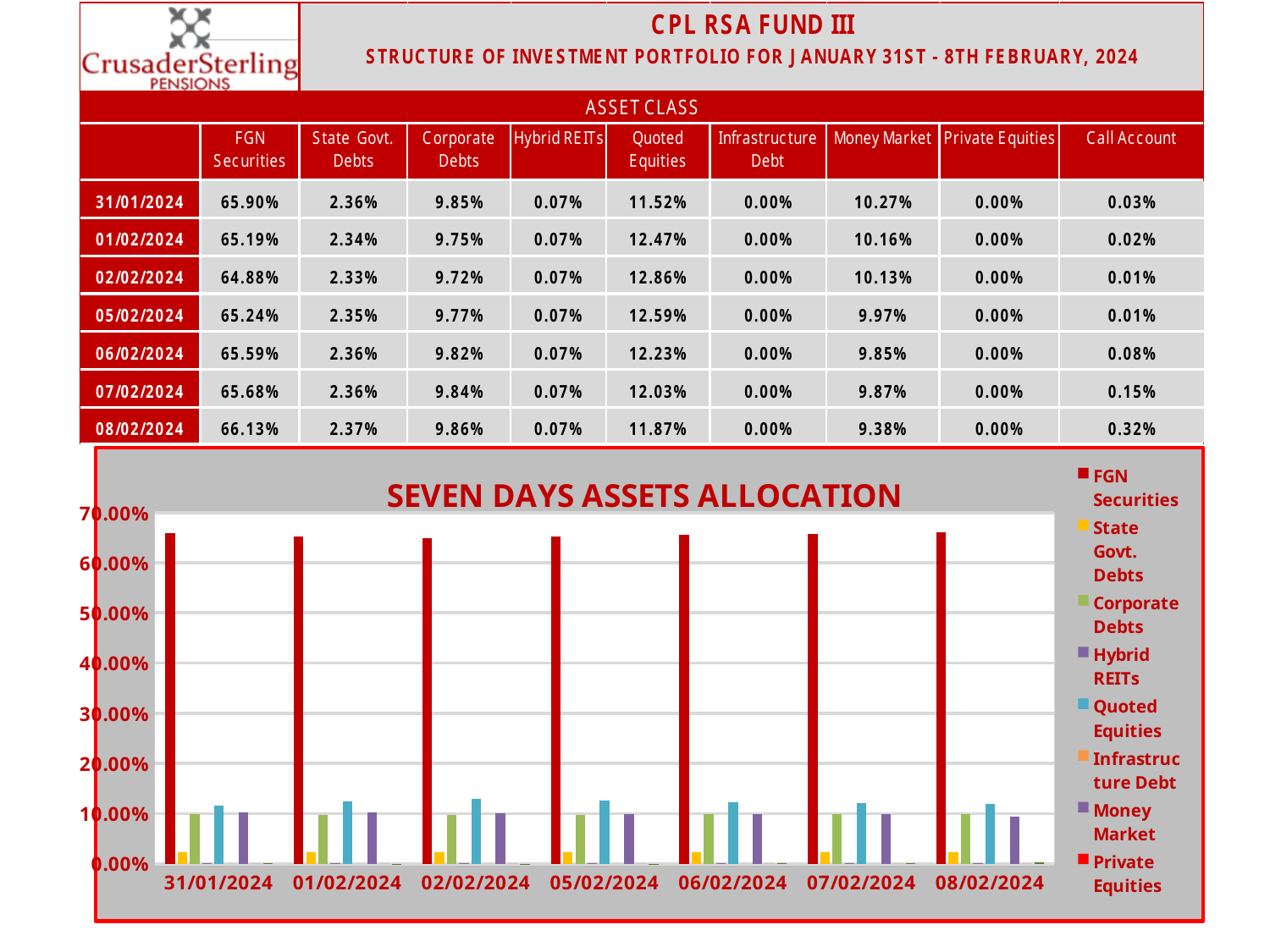
According to the slide, what is the Quoted Equities allocation on 02/02/2024? 12.86% In the 'SEVEN DAYS ASSETS ALLOCATION' chart, is the Corporate Debts value for 05/02/2024 greater or less than 20.00%? less How many dates are shown along the x axis of the 'SEVEN DAYS ASSETS ALLOCATION' chart? 7 Which asset class has the tallest bars on every date in the 'SEVEN DAYS ASSETS ALLOCATION' chart? FGN Securities According to the slide, what is the FGN Securities allocation on 08/02/2024? 66.13% According to the slide, what is the Money Market allocation on 31/01/2024? 10.27% On 01/02/2024, which is larger: Quoted Equities or Money Market? Quoted Equities By how much does the FGN Securities allocation on 08/02/2024 exceed that on 31/01/2024? 0.23% What kind of chart is the 'SEVEN DAYS ASSETS ALLOCATION' chart? bar chart In the 'SEVEN DAYS ASSETS ALLOCATION' chart, is the FGN Securities value for 31/01/2024 greater or less than 60.00%? greater What is the title of the chart on the slide? SEVEN DAYS ASSETS ALLOCATION In the 'SEVEN DAYS ASSETS ALLOCATION' chart, is the Quoted Equities value for 02/02/2024 greater or less than 20.00%? less